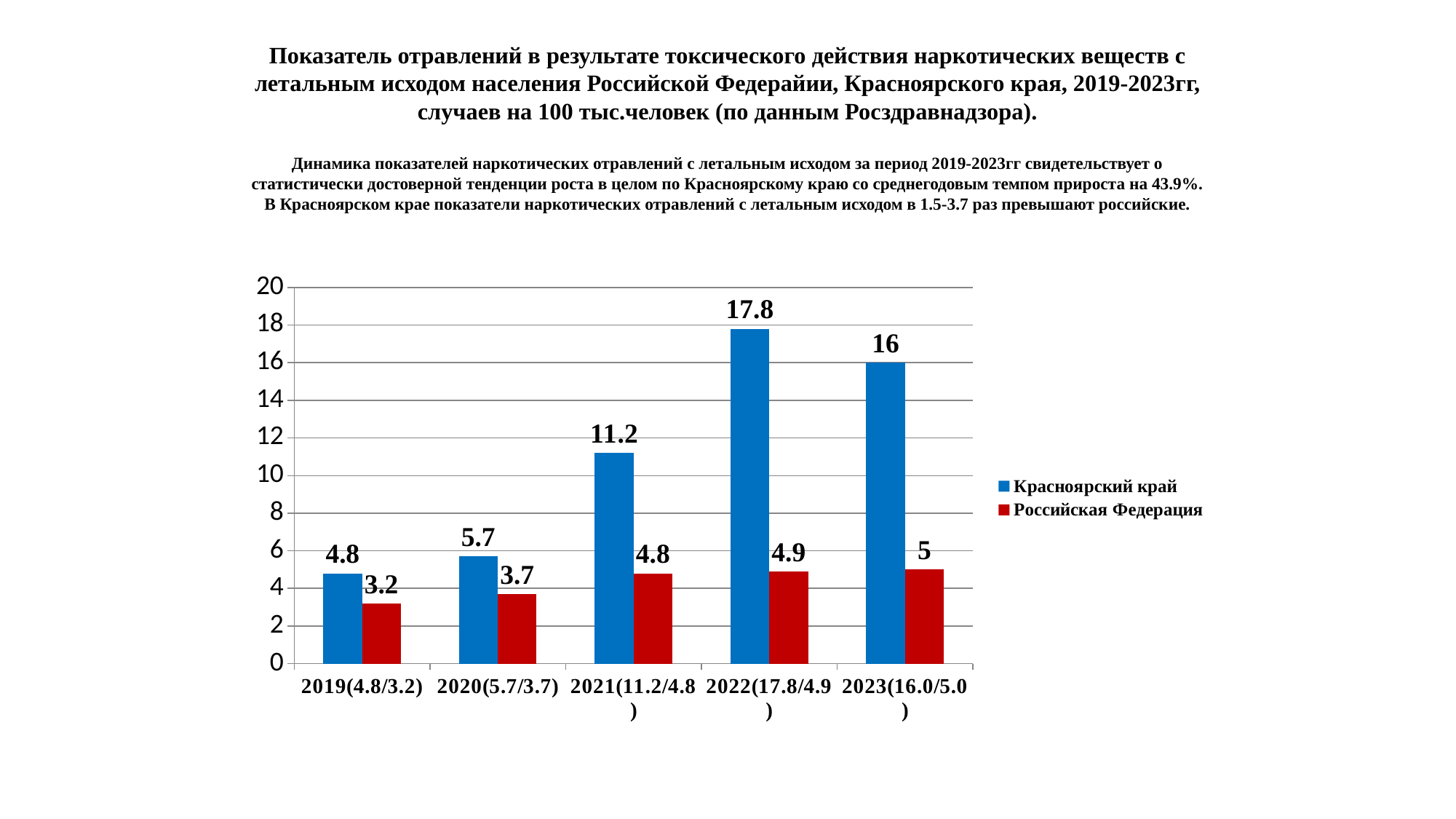
What is the value for Красноярский край in 2022? 17.8 What is the difference between the Красноярский край and Российская Федерация values in 2022? 12.9 In which year is the value for Красноярский край highest? 2022 How many years are shown on the x axis? 5 What is the value for Российская Федерация in 2021? 4.8 What is the value for Красноярский край in 2019? 4.8 Which colour represents Российская Федерация in the chart? Red How many series does the legend list? 2 Which is larger in 2020: the value for Красноярский край or for Российская Федерация? Красноярский край What is the value for Российская Федерация in 2023? 5 What kind of chart is shown on the slide? Bar chart In which year is the value for Российская Федерация lowest? 2019